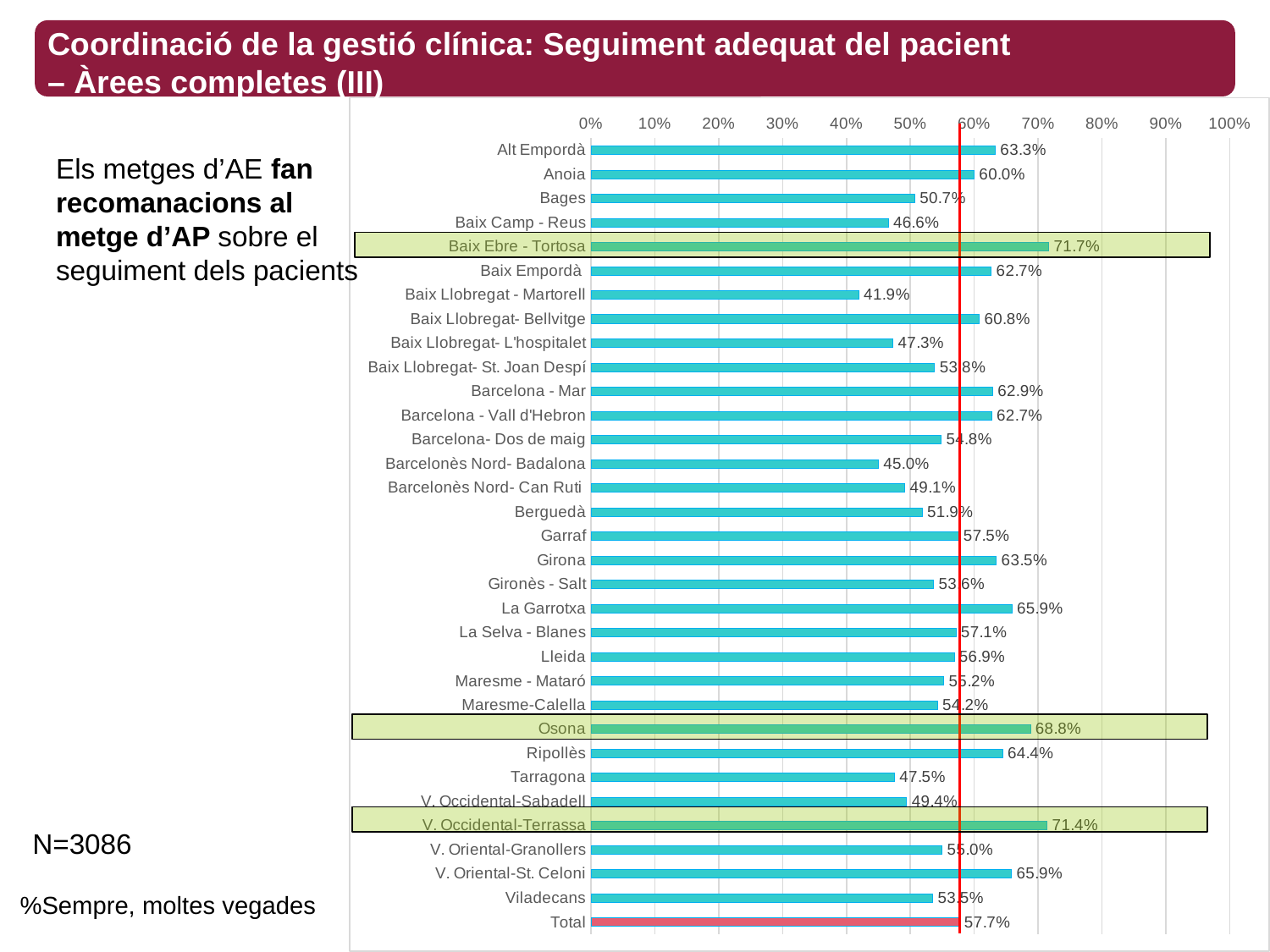
Which area has the lowest value? Baix Llobregat - Martorell What is the value for Baix Ebre - Tortosa? 71.7% Is the value for Tarragona greater or less than 50%? less What kind of chart is shown on the slide? Bar chart How many bars are plotted in the chart, including Total? 33 What is the value for Osona? 68.8% What is the value for Baix Llobregat - Martorell? 41.9% What is the difference between the value for Osona and the Total value? 11.1 percentage points Which area has the highest value? Baix Ebre - Tortosa What is the value for Ripollès? 64.4% What is the value shown for Total? 57.7% Which is larger, the value for Girona or the value for Alt Empordà? Girona